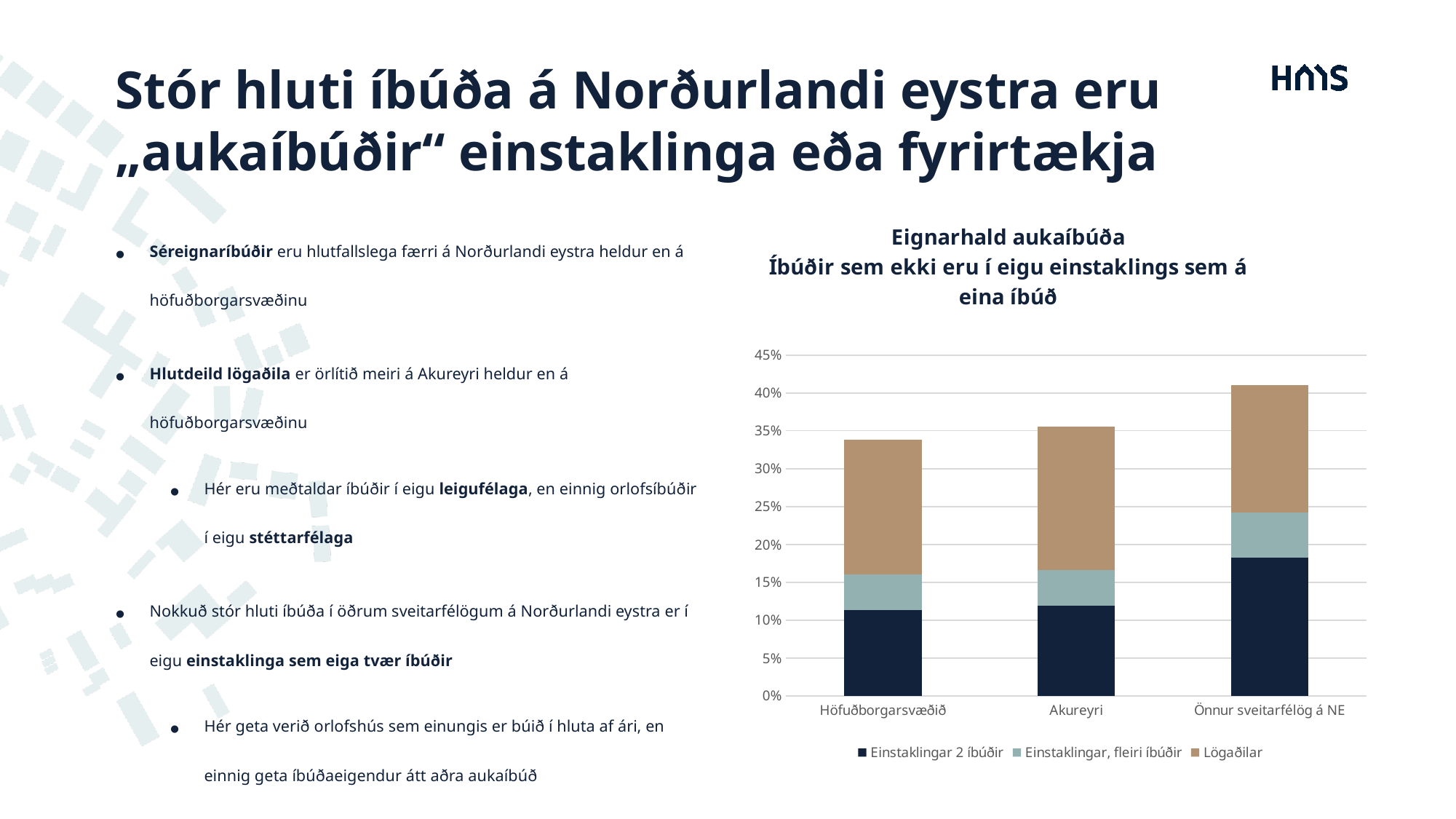
Which legend entry is shown in the tan/brown colour? Lögaðilar How many categories are shown on the x axis of the chart? 3 Is the total stacked value for Önnur sveitarfélög á NE greater or less than 40%? greater Is the total stacked value for Höfuðborgarsvæðið greater or less than 35%? less Is the value of Einstaklingar 2 íbúðir for Önnur sveitarfélög á NE greater or less than 15%? greater Which category has the highest total stacked bar? Önnur sveitarfélög á NE What is the first line of the chart title? Eignarhald aukaíbúða How many series does the chart legend list? 3 What kind of chart is shown on the slide? Stacked bar chart Which category has the lowest total stacked bar? Höfuðborgarsvæðið Which has a larger Einstaklingar 2 íbúðir segment: Höfuðborgarsvæðið or Önnur sveitarfélög á NE? Önnur sveitarfélög á NE